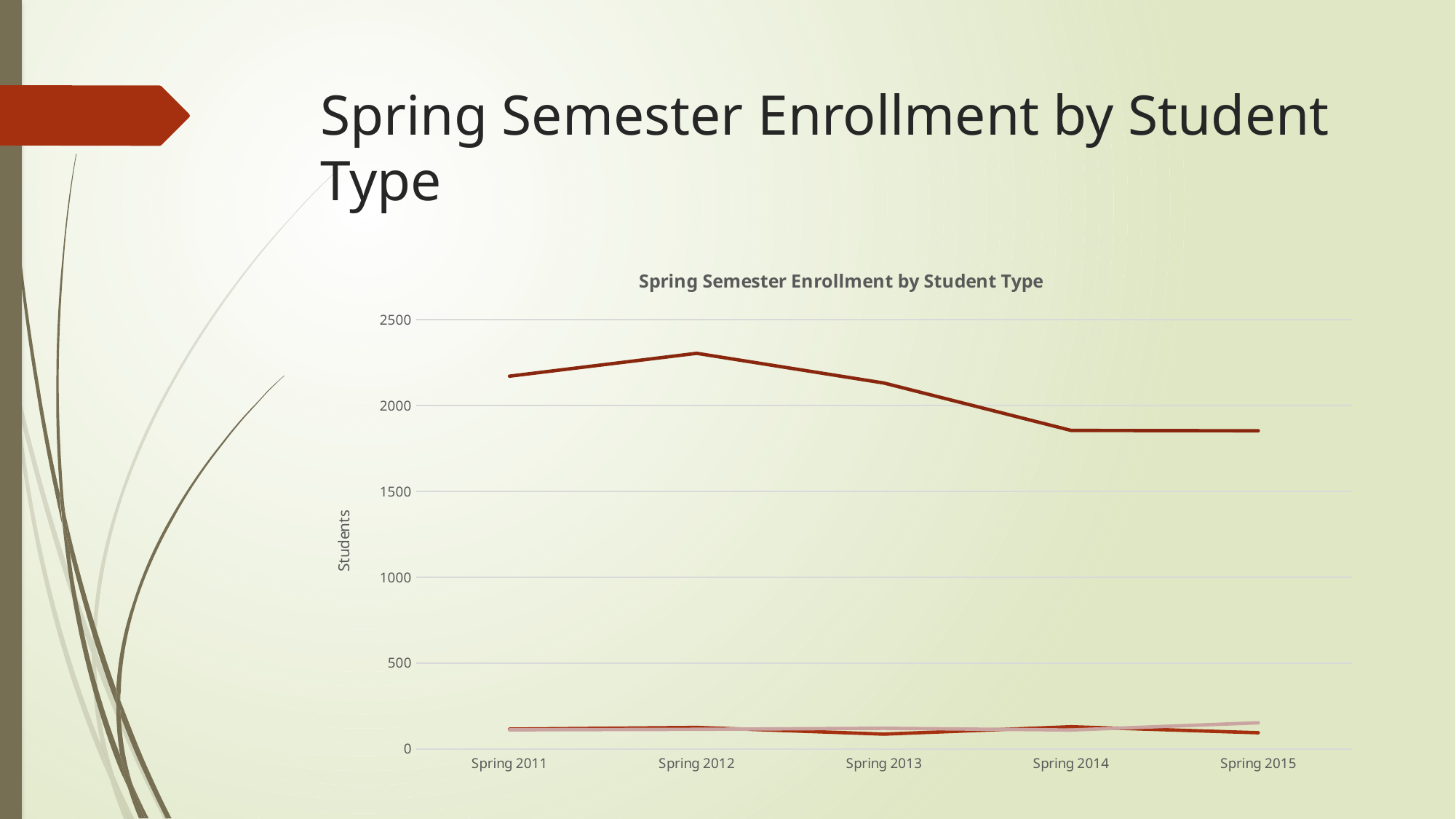
Does the top (dark red) line rise or fall from Spring 2011 to Spring 2012? rise Does the top (dark red) line rise or fall from Spring 2012 to Spring 2014? fall What is the label on the vertical axis of the chart? Students Is the value of the top (dark red) line for Spring 2012 greater or less than 2000? greater Is the value of the top (dark red) line for Spring 2012 larger or smaller than its value for Spring 2015? larger In which semester does the top (dark red) line reach its highest value? Spring 2012 How many semesters are shown along the x axis of the chart? 5 What kind of chart is shown on the slide? line chart Is the value of the top (dark red) line for Spring 2014 greater or less than 2000? less Is the value of the top (dark red) line for Spring 2011 greater or less than 2500? less What is the title of the chart? Spring Semester Enrollment by Student Type